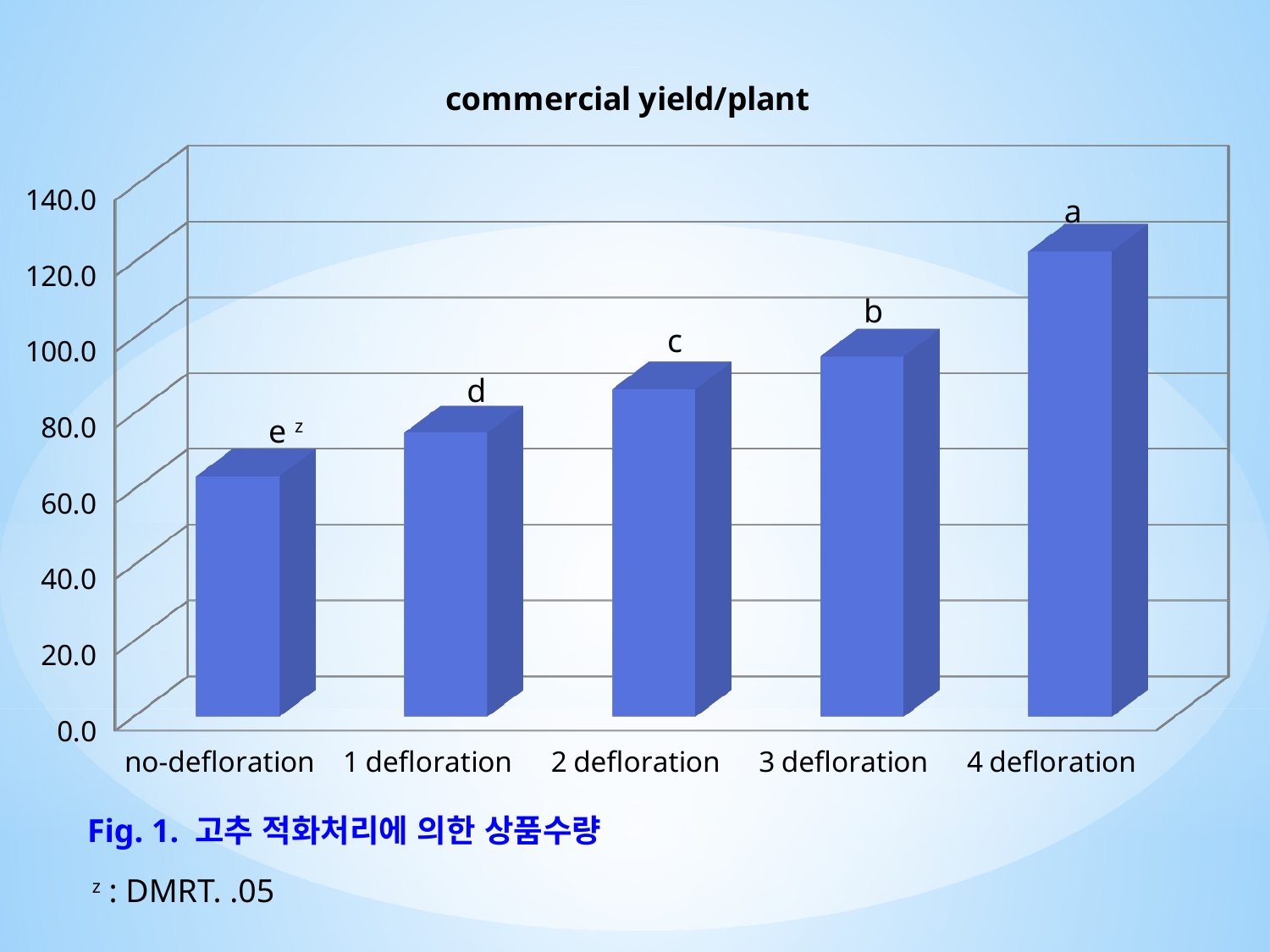
What letter label is printed above the bar for 4 defloration? a Which category has the lowest commercial yield per plant? no-defloration Which category has the highest commercial yield per plant? 4 defloration Is the value for no-defloration greater or less than 80? less What type of chart is shown on the slide? bar chart Which is larger, the value for 3 defloration or the value for 1 defloration? 3 defloration Is the value for 1 defloration greater or less than 100? less Is the value for 4 defloration greater or less than 100? greater Do the values rise or fall moving from no-defloration to 4 defloration along the x axis? rise What is the title of the chart? commercial yield/plant How many categories are shown on the x axis of the chart? 5